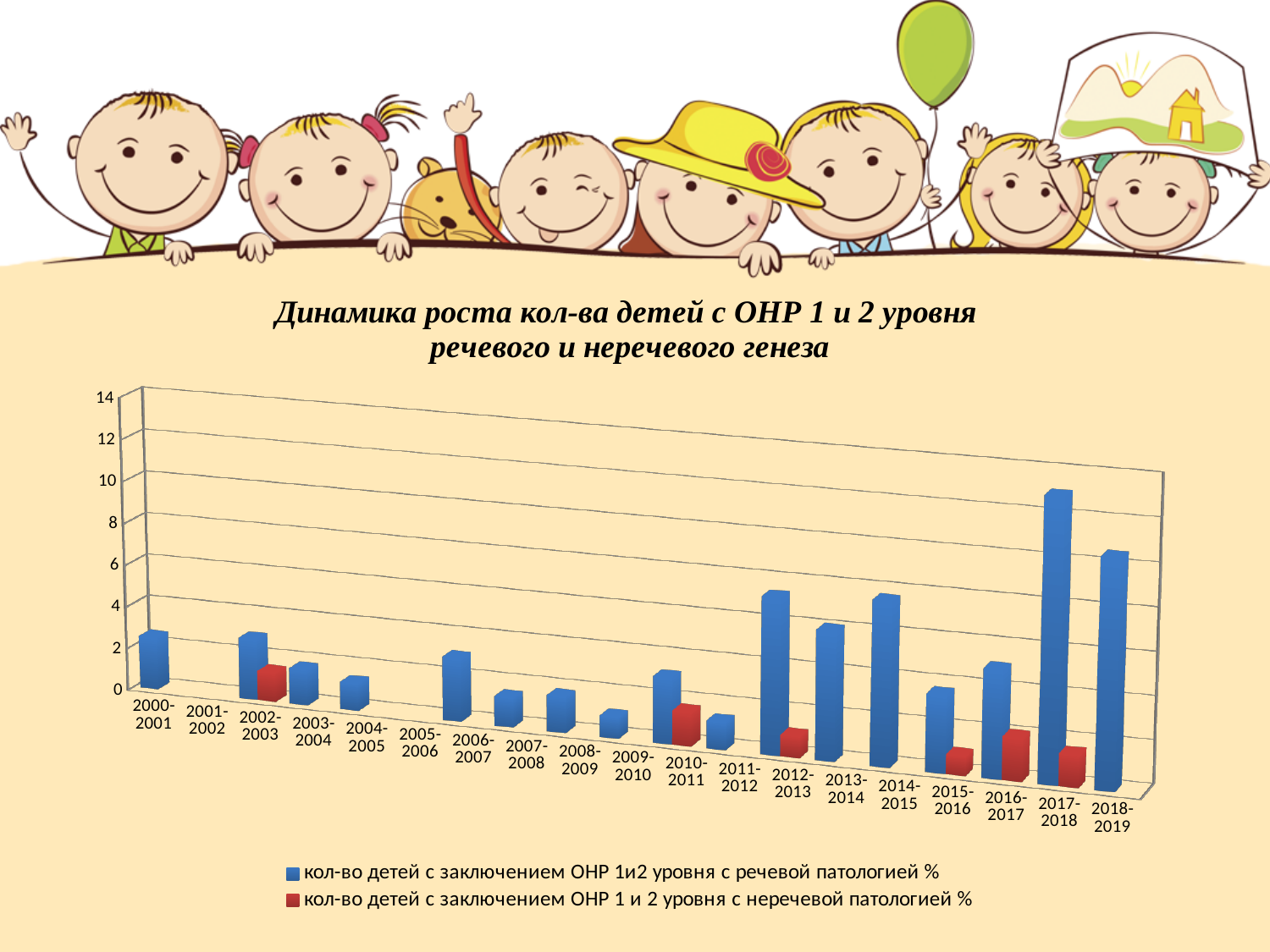
Which blue bar is taller, 2017-2018 or 2018-2019? 2017-2018 Which blue bar is taller, 2012-2013 or 2013-2014? 2012-2013 Is the blue bar for 2018-2019 greater or less than 4? greater How many series does the legend list? 2 Is the blue bar for 2017-2018 greater or less than 6? greater Do the blue bars generally rise or fall from 2000-2001 to 2018-2019? rise What kind of chart is shown on the slide? bar chart Which colour represents children with non-speech pathology (неречевой патологией) in the legend? red How many school-year categories are shown on the x axis? 19 Is the blue bar for 2000-2001 greater or less than 4? less Which school year has the highest blue bar (children with speech pathology)? 2017-2018